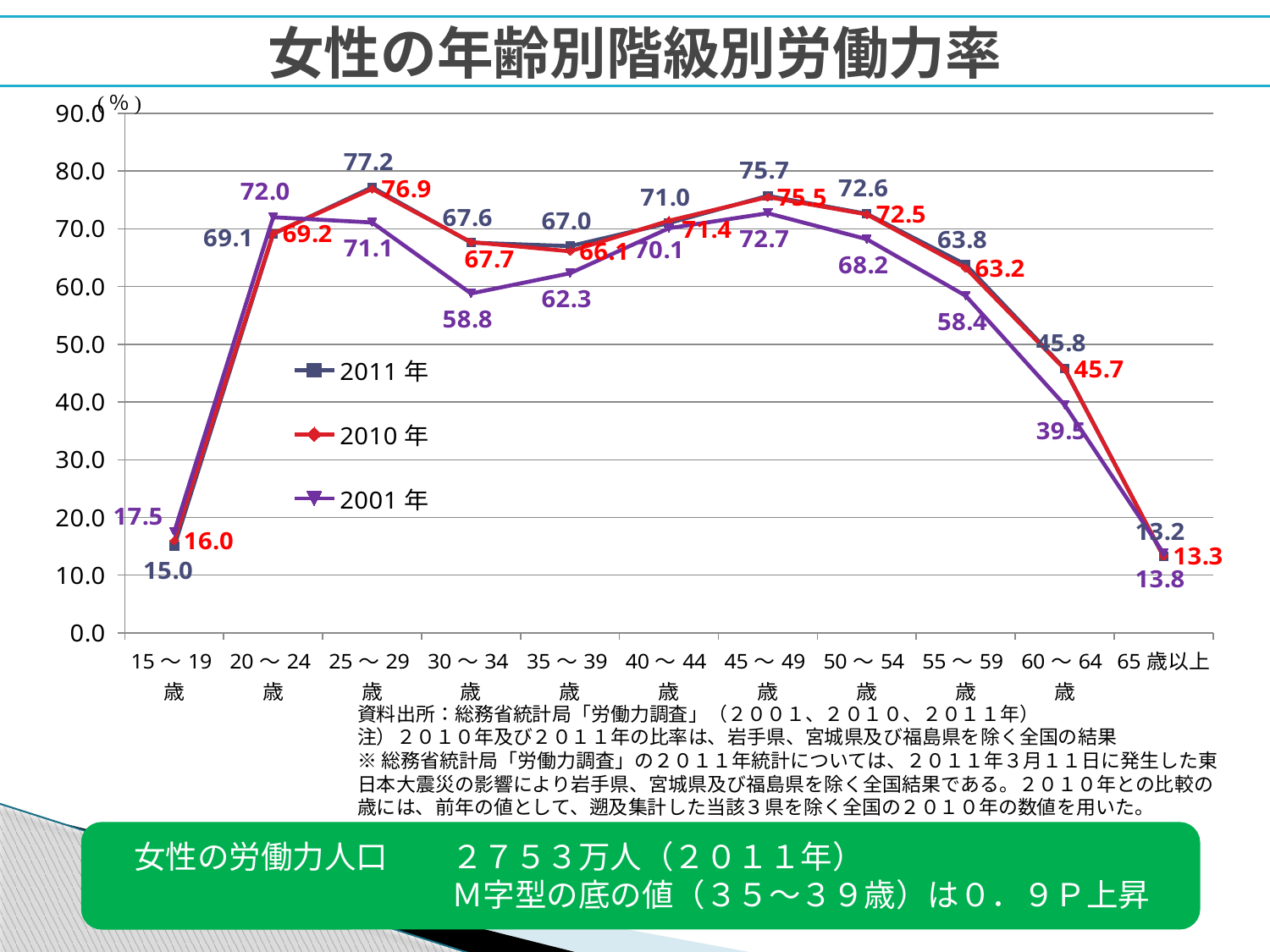
What is the 2010年 value for 35～39歳? 66.1 Which age category has the lowest 2011年 value? 65歳以上 What is the 2011年 value for 25～29歳? 77.2 What is the title of the chart? 女性の年齢別階級別労働力率 What type of chart is shown on the slide? line chart How many series does the legend list? 3 What is the difference between the 2011年 and 2001年 values for 30～34歳? 8.8 Which age category has the highest 2001年 value? 45～49歳 How many age categories are plotted along the x axis? 11 Which is larger for 60～64歳, the 2010年 value or the 2001年 value? 2010年 Do the 2011年 values rise or fall from 50～54歳 to 65歳以上? fall What is the 2001年 value for 30～34歳? 58.8